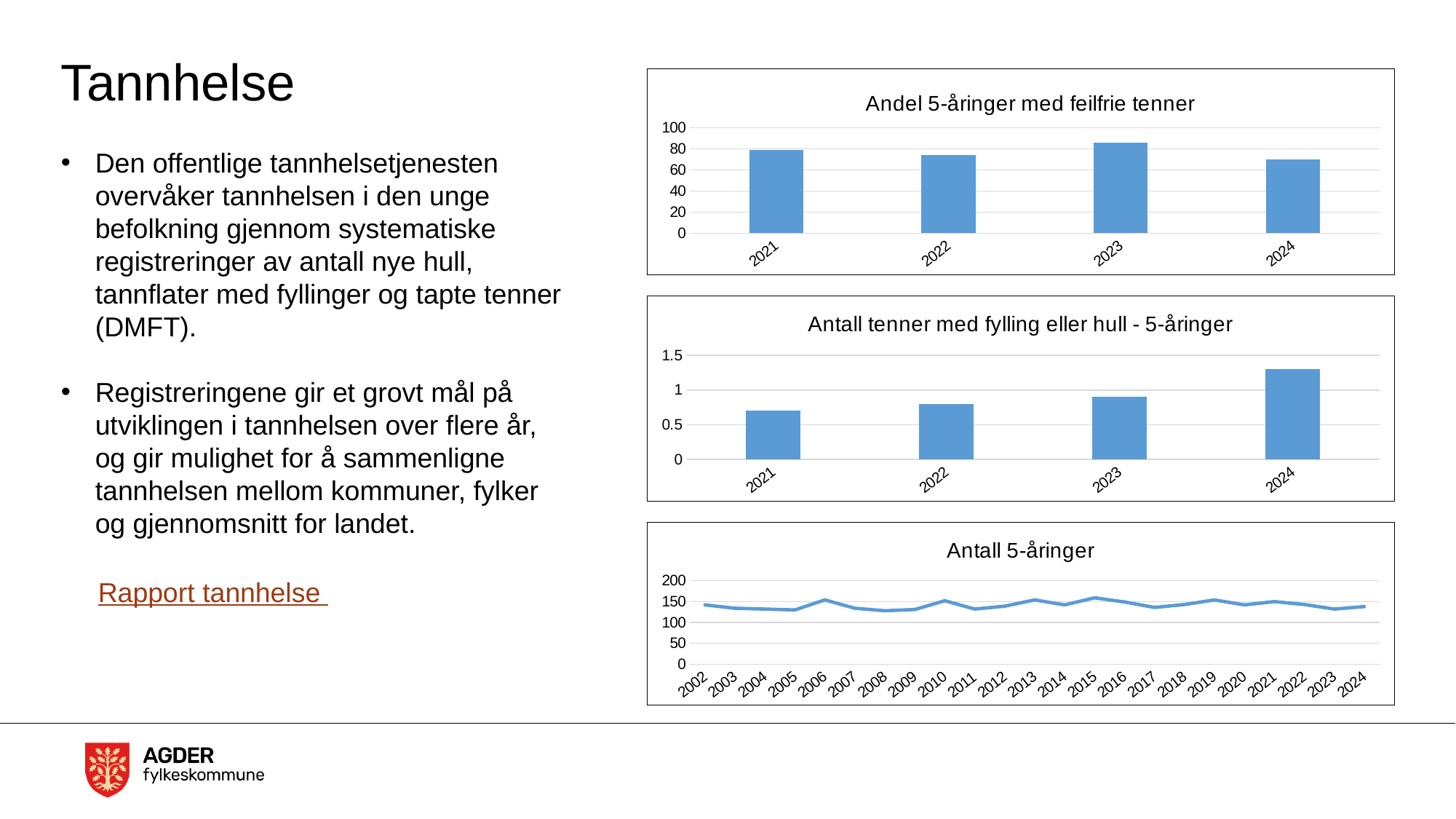
In the chart 'Andel 5-åringer med feilfrie tenner', which year has the lowest value? 2024 In the chart 'Andel 5-åringer med feilfrie tenner', which year has the highest value? 2023 What kind of chart is 'Antall 5-åringer'? line chart In the chart 'Andel 5-åringer med feilfrie tenner', is the value for 2024 greater or less than 80? less How many years are shown in the chart 'Andel 5-åringer med feilfrie tenner'? 4 In the chart 'Antall tenner med fylling eller hull - 5-åringer', which year has the lowest value? 2021 How many years are shown on the x axis of the chart 'Antall 5-åringer'? 23 In the chart 'Antall tenner med fylling eller hull - 5-åringer', is the value for 2024 greater or less than 1? greater In the chart 'Antall tenner med fylling eller hull - 5-åringer', do the values rise or fall from 2021 to 2024? rise In the chart 'Antall tenner med fylling eller hull - 5-åringer', which year has the highest value? 2024 In the chart 'Andel 5-åringer med feilfrie tenner', is the value for 2023 greater or less than 80? greater